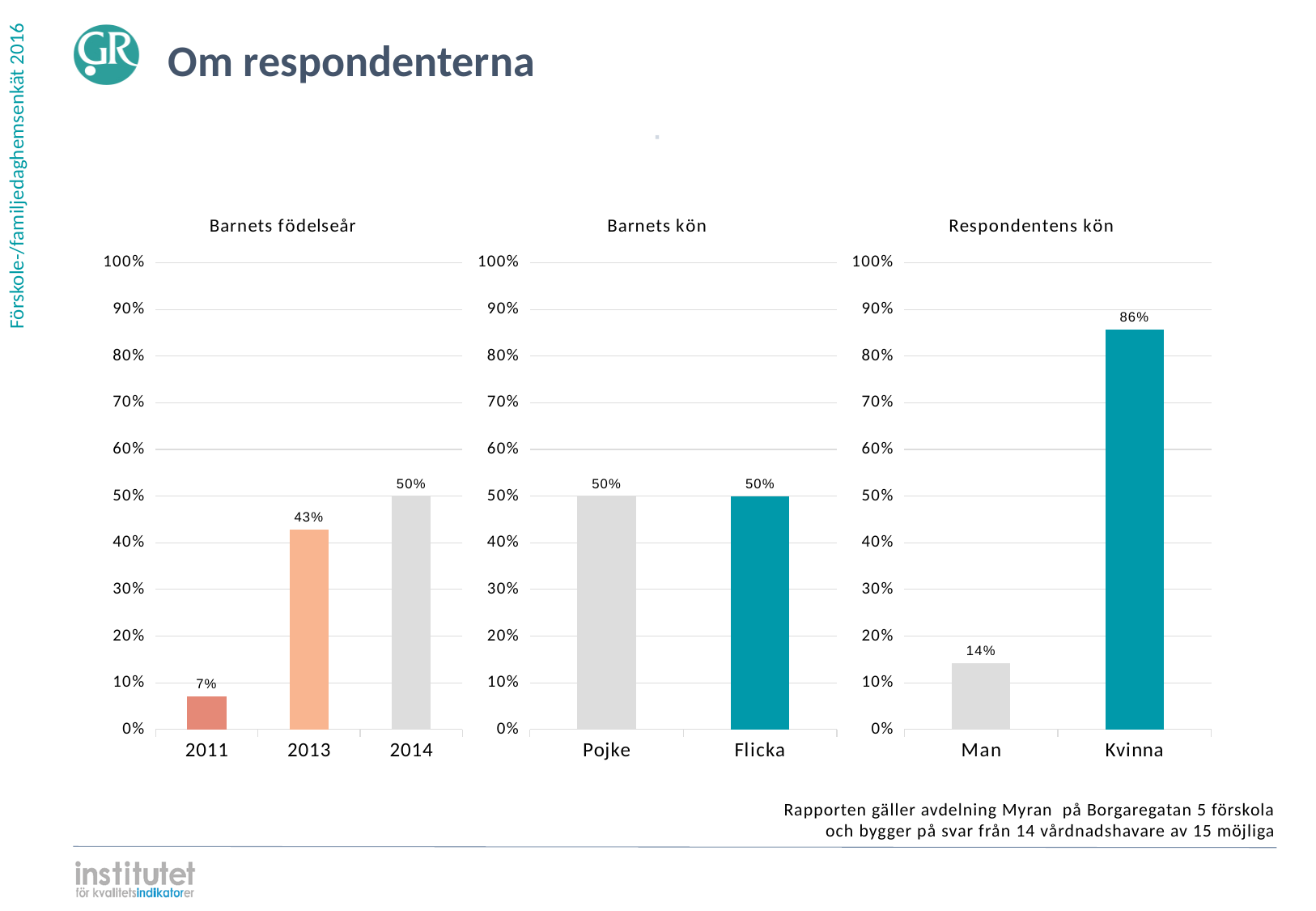
In the 'Barnets kön' chart, what is the value for Pojke? 50% In the 'Barnets födelseår' chart, what is the value for 2013? 43% In the 'Barnets födelseår' chart, what is the difference between the values for 2014 and 2011? 43% In the 'Barnets födelseår' chart, which birth year has the highest value? 2014 In the 'Respondentens kön' chart, what is the difference between the values for Kvinna and Man? 72% In the 'Respondentens kön' chart, is the value for Man greater or less than 20%? less In the 'Barnets födelseår' chart, how many birth-year categories are shown? 3 In the 'Barnets födelseår' chart, which birth year has the lowest value? 2011 What kind of chart is the 'Barnets kön' chart? Bar chart In the 'Barnets kön' chart, what is the value for Flicka? 50% In the 'Respondentens kön' chart, what is the value for Kvinna? 86% In the 'Respondentens kön' chart, which category is larger, Man or Kvinna? Kvinna